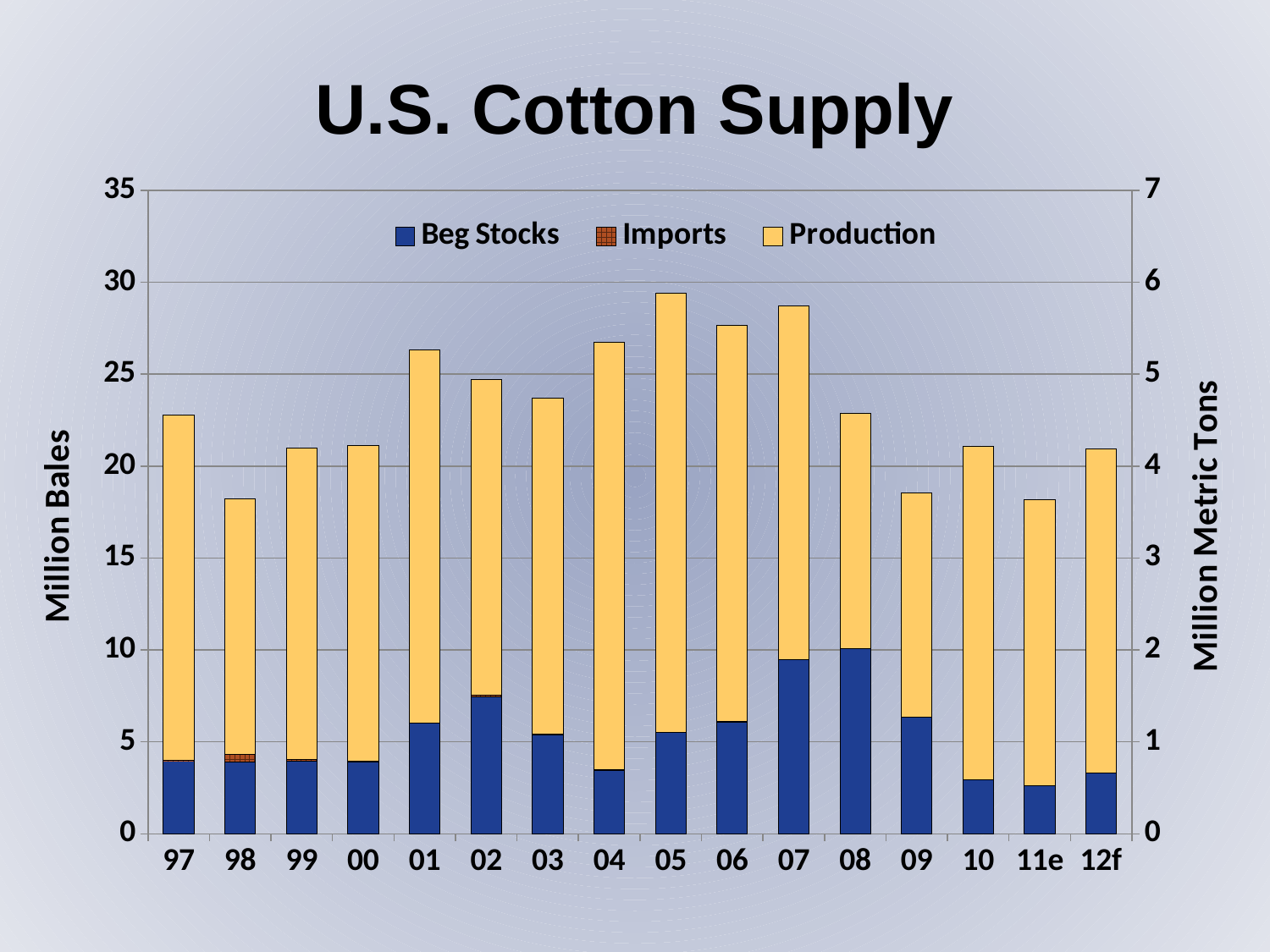
How many years (categories) are shown on the x axis? 16 Which year has the tallest total bar? 05 What is the title of the left vertical axis? Million Bales Is the total bar for 98 greater or less than 20 million bales? less What is the title of the chart? U.S. Cotton Supply What kind of chart is shown on the slide? Stacked bar chart Is the Beg Stocks value for 08 greater or less than 5 million bales? greater Which has the taller total bar, 07 or 08? 07 Which year has the largest Beg Stocks segment? 08 Is the total bar for 05 greater or less than 25 million bales? greater How many series does the legend list? 3